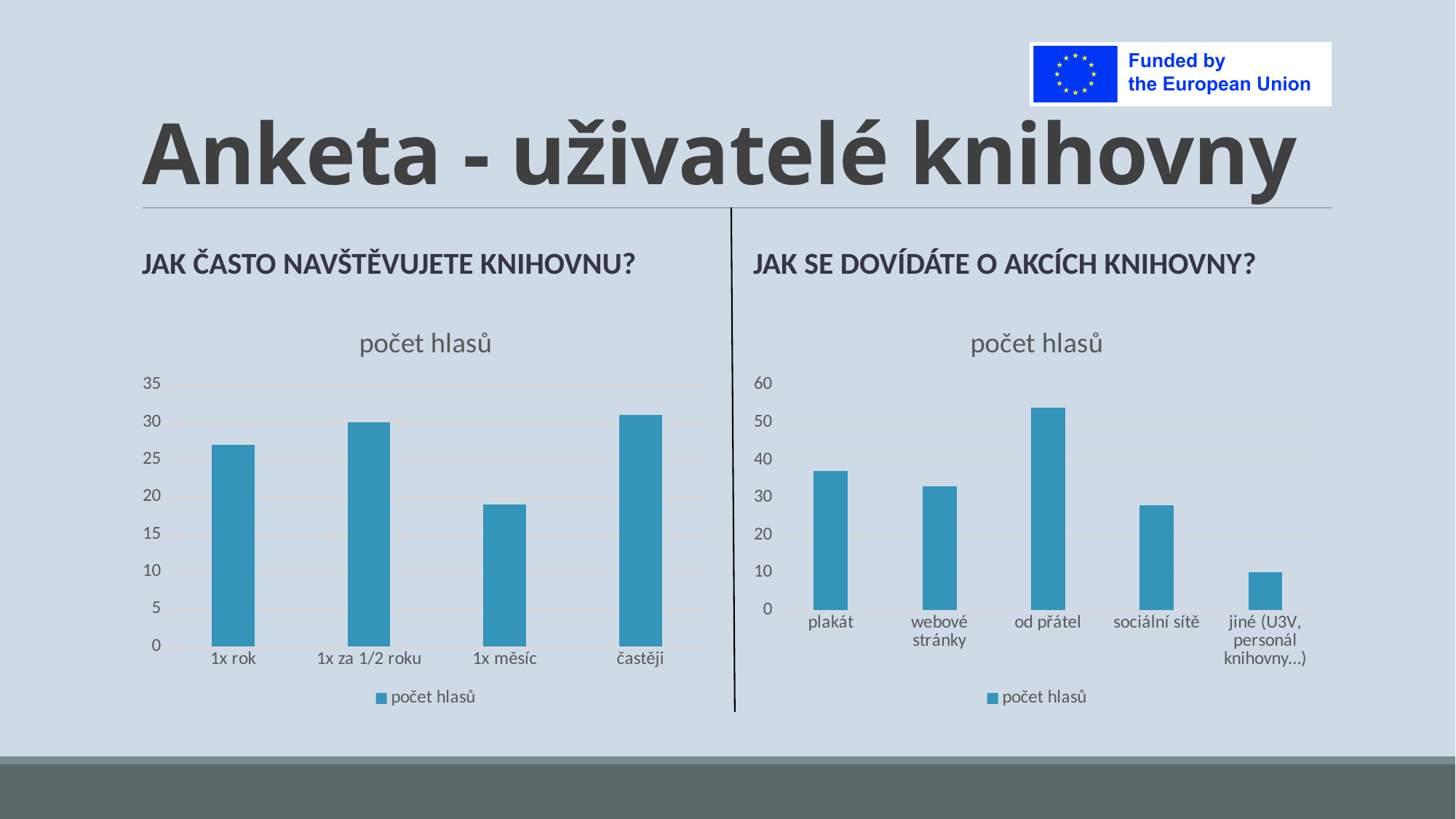
On the right chart (JAK SE DOVÍDÁTE O AKCÍCH KNIHOVNY?), which category has the lowest value? jiné (U3V, personál knihovny…) How many categories are shown on the left chart (JAK ČASTO NAVŠTĚVUJETE KNIHOVNU?)? 4 On the left chart (JAK ČASTO NAVŠTĚVUJETE KNIHOVNU?), is the value for častěji greater or less than 25? greater What type of chart is the left chart (JAK ČASTO NAVŠTĚVUJETE KNIHOVNU?)? bar chart On the right chart (JAK SE DOVÍDÁTE O AKCÍCH KNIHOVNY?), which category has the highest value? od přátel On the left chart (JAK ČASTO NAVŠTĚVUJETE KNIHOVNU?), which category has the lowest value? 1x měsíc On the right chart (JAK SE DOVÍDÁTE O AKCÍCH KNIHOVNY?), is the value for od přátel greater or less than 50? greater How many categories are shown on the right chart (JAK SE DOVÍDÁTE O AKCÍCH KNIHOVNY?)? 5 On the left chart (JAK ČASTO NAVŠTĚVUJETE KNIHOVNU?), which is larger: the value for 1x rok or for 1x měsíc? 1x rok On the right chart (JAK SE DOVÍDÁTE O AKCÍCH KNIHOVNY?), which is larger: the value for plakát or for sociální sítě? plakát